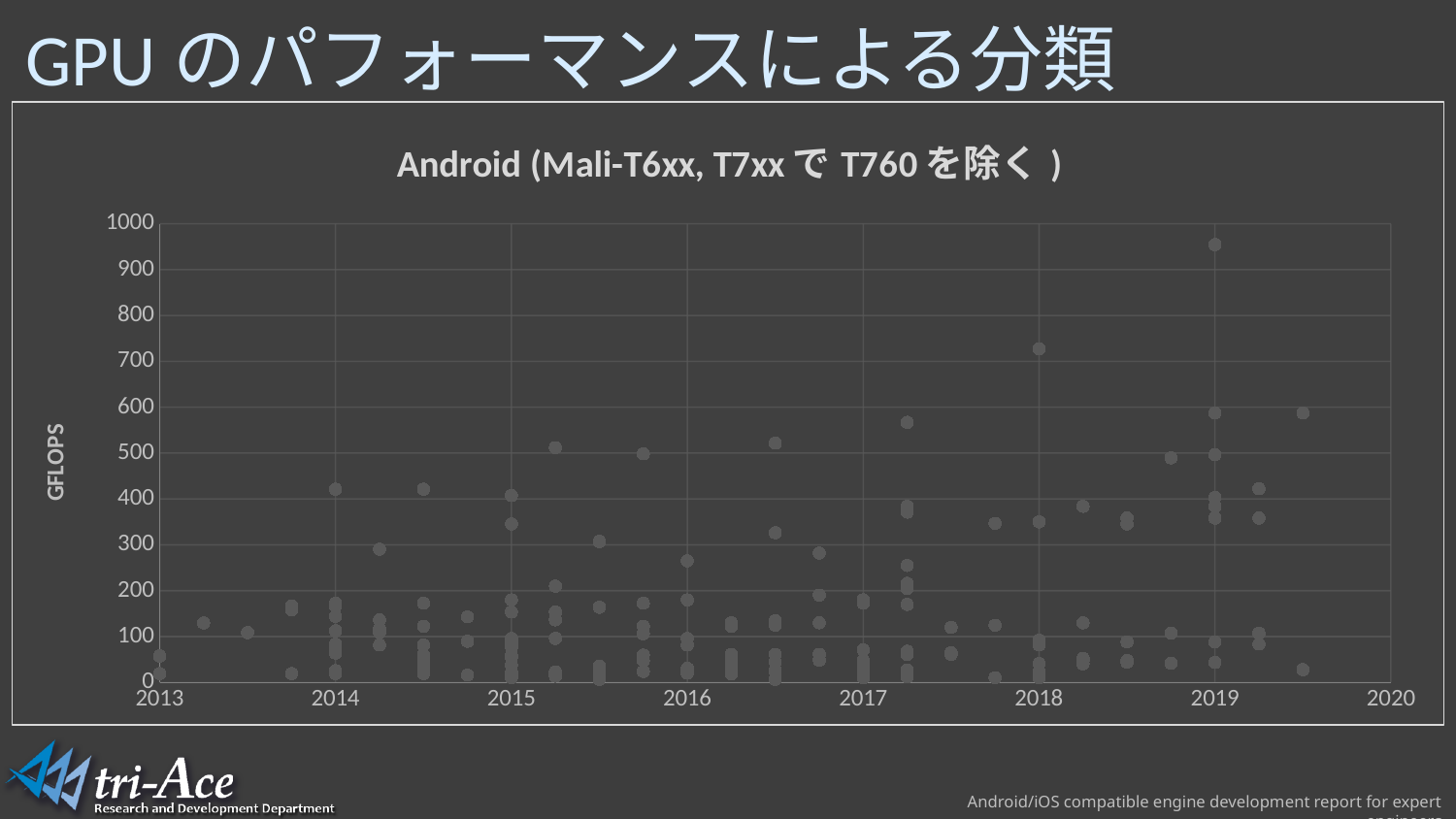
Is the highest plotted value on the chart greater or less than 900? greater What kind of chart is shown on the slide? scatter chart Is the highest value plotted near 2013 greater or less than 200? less Is the highest value plotted near 2018 greater or less than 600? greater What is the title of the chart? Android (Mali-T6xx, T7xx で T760 を除く ) Near which year on the x axis does the highest plotted point appear? 2019 Which is larger: the highest value plotted near 2019 or the highest value plotted near 2014? 2019 Do the highest plotted values generally rise or fall from 2013 to 2019? rise What is the label on the vertical axis of the chart? GFLOPS